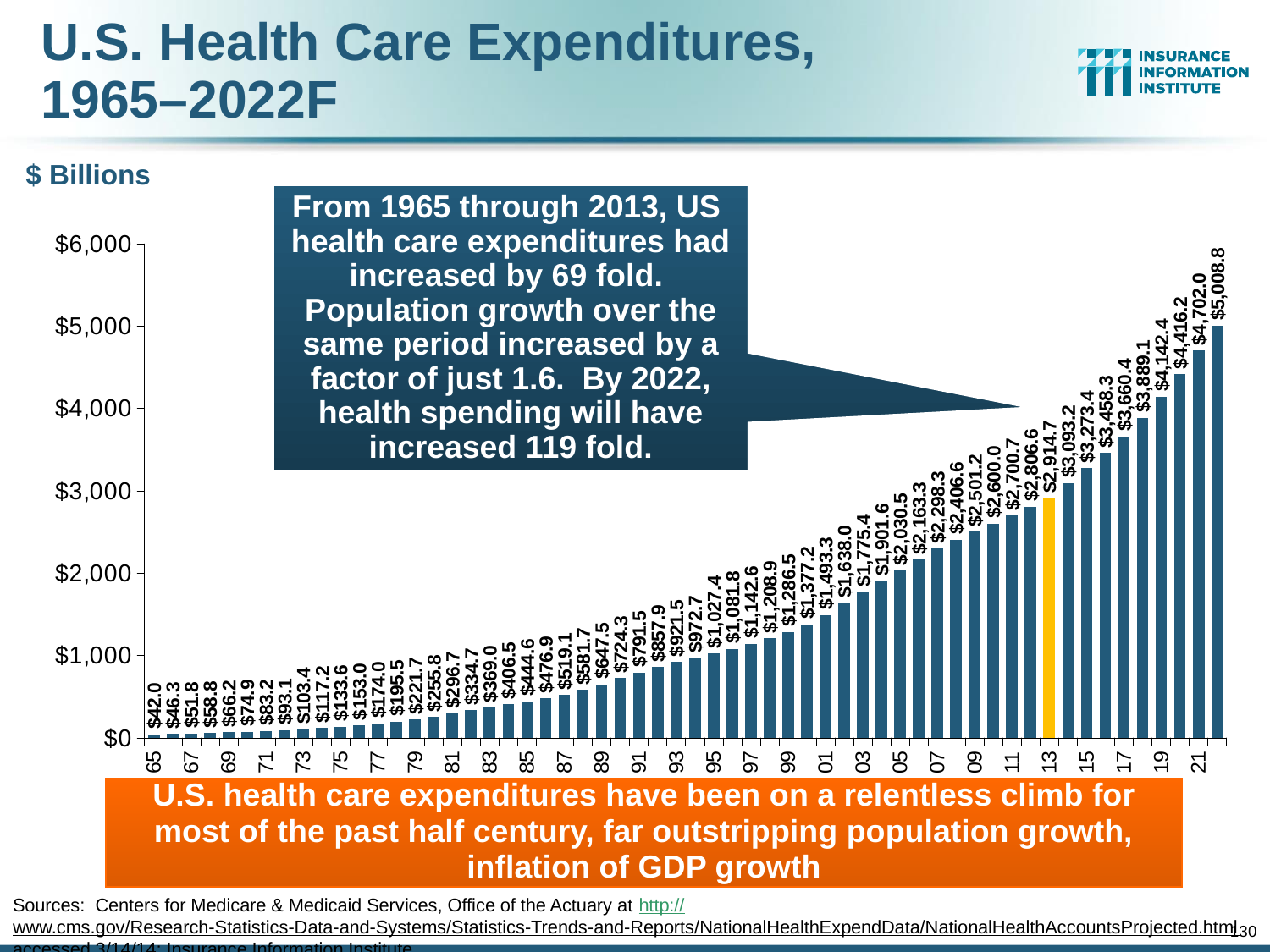
What kind of chart is shown on the slide? bar chart What is the value of the highlighted (yellow) bar for 2013? $2,914.7 What is the value of the first bar (1965) in the chart? $42.0 What unit is indicated for the y axis of the chart? $ Billions What is the difference between the 2022 value and the 2013 value? $2,094.1 Do the values generally rise or fall from 1965 to 2022 along the x axis? rise How many bars (years) are plotted in the chart? 58 Which year has the lowest health care expenditure in the chart? 1965 Is the value for 2013 greater or less than $3,000? less What is the value of the last bar (2022F) in the chart? $5,008.8 What is the value shown for 2021 in the chart? $4,702.0 Which year has the highest health care expenditure in the chart? 2022